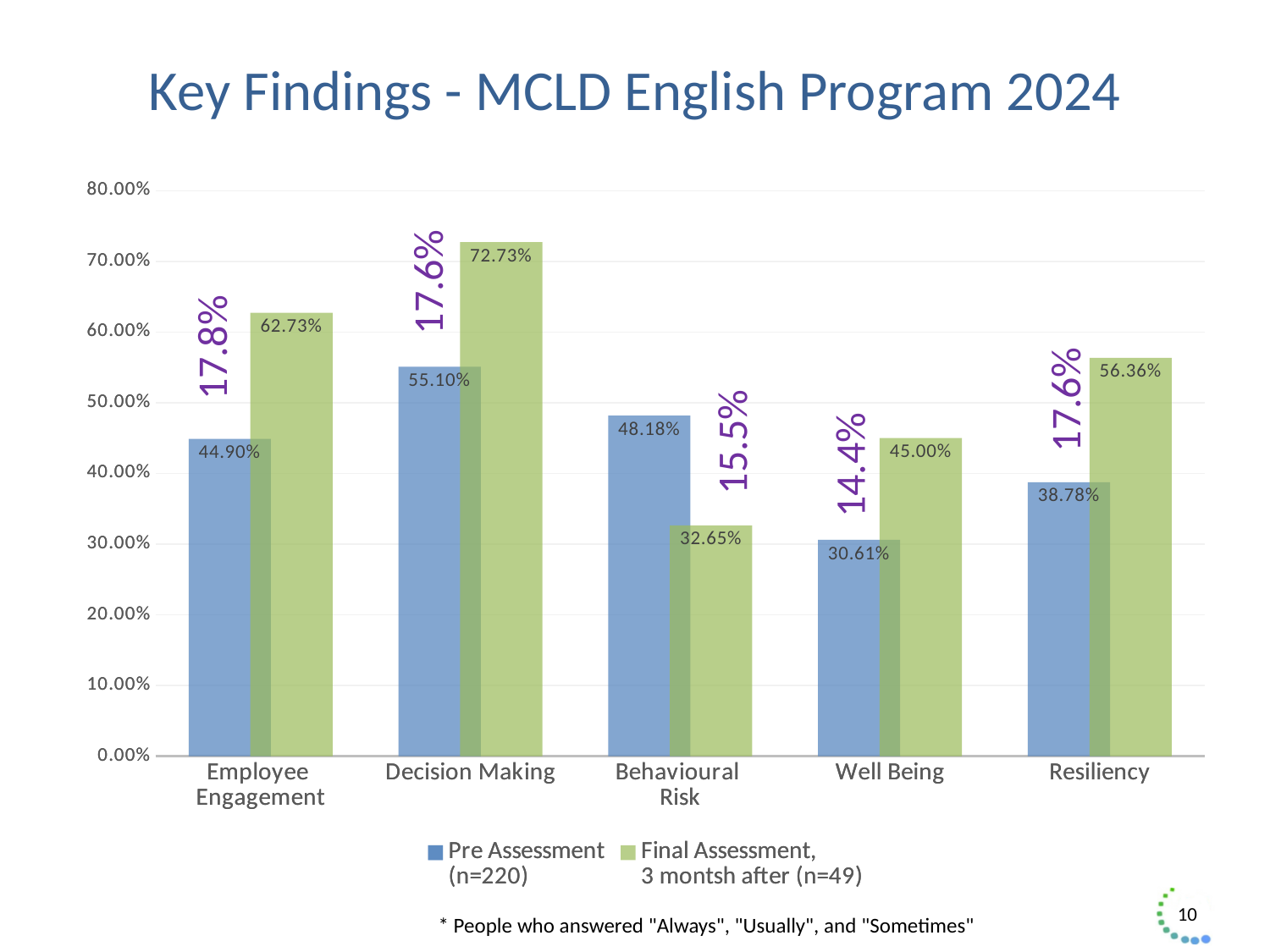
Which category has the highest Final Assessment value? Decision Making How many series does the legend list? 2 What is the Final Assessment value for Decision Making? 72.73% How many categories are shown on the x axis? 5 What is the Final Assessment value for Behavioural Risk? 32.65% What is the Pre Assessment value for Employee Engagement? 44.90% What kind of chart is shown on the slide? Bar chart Which is larger for Behavioural Risk: the Pre Assessment value or the Final Assessment value? Pre Assessment What is the difference between the Final Assessment and Pre Assessment values for Resiliency? 17.58% Which category has the lowest Pre Assessment value? Well Being What is the title of the slide? Key Findings - MCLD English Program 2024 What is the Pre Assessment value for Well Being? 30.61%